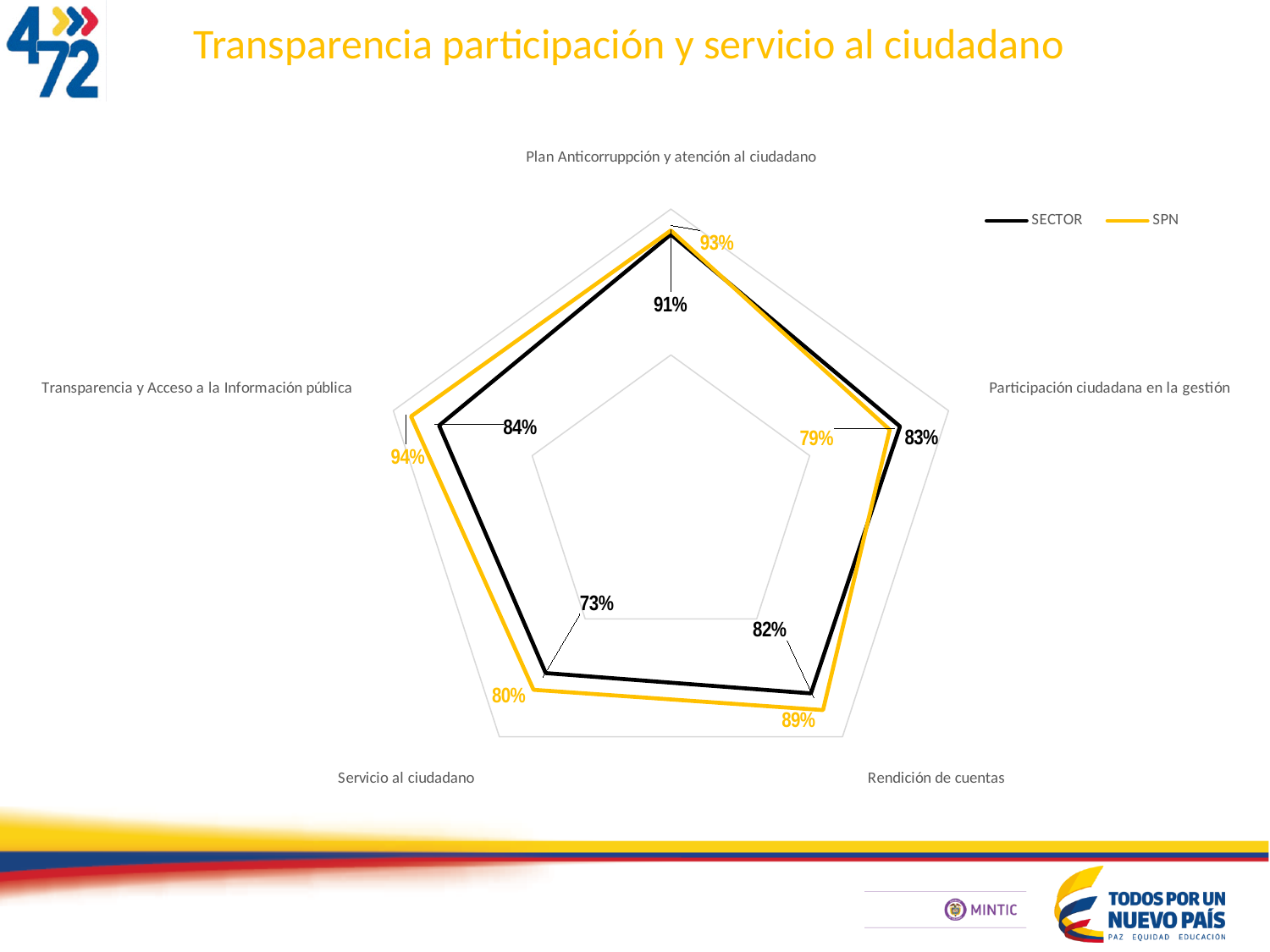
Which category has the lowest SECTOR value? Servicio al ciudadano What kind of chart is shown on the slide? Radar chart For Participación ciudadana en la gestión, which series has the larger value, SECTOR or SPN? SECTOR What is the SECTOR value for Servicio al ciudadano? 73% What is the SPN value for Transparencia y Acceso a la Información pública? 94% Which colour represents the SPN series in the legend? Yellow Which category has the highest SPN value? Transparencia y Acceso a la Información pública What is the SECTOR value for Plan Anticorruppción y atención al ciudadano? 91% How many categories are plotted on the radar chart? 5 What is the SPN value for Rendición de cuentas? 89% How many series does the legend list? 2 What is the difference between the SPN and SECTOR values for Transparencia y Acceso a la Información pública? 10%